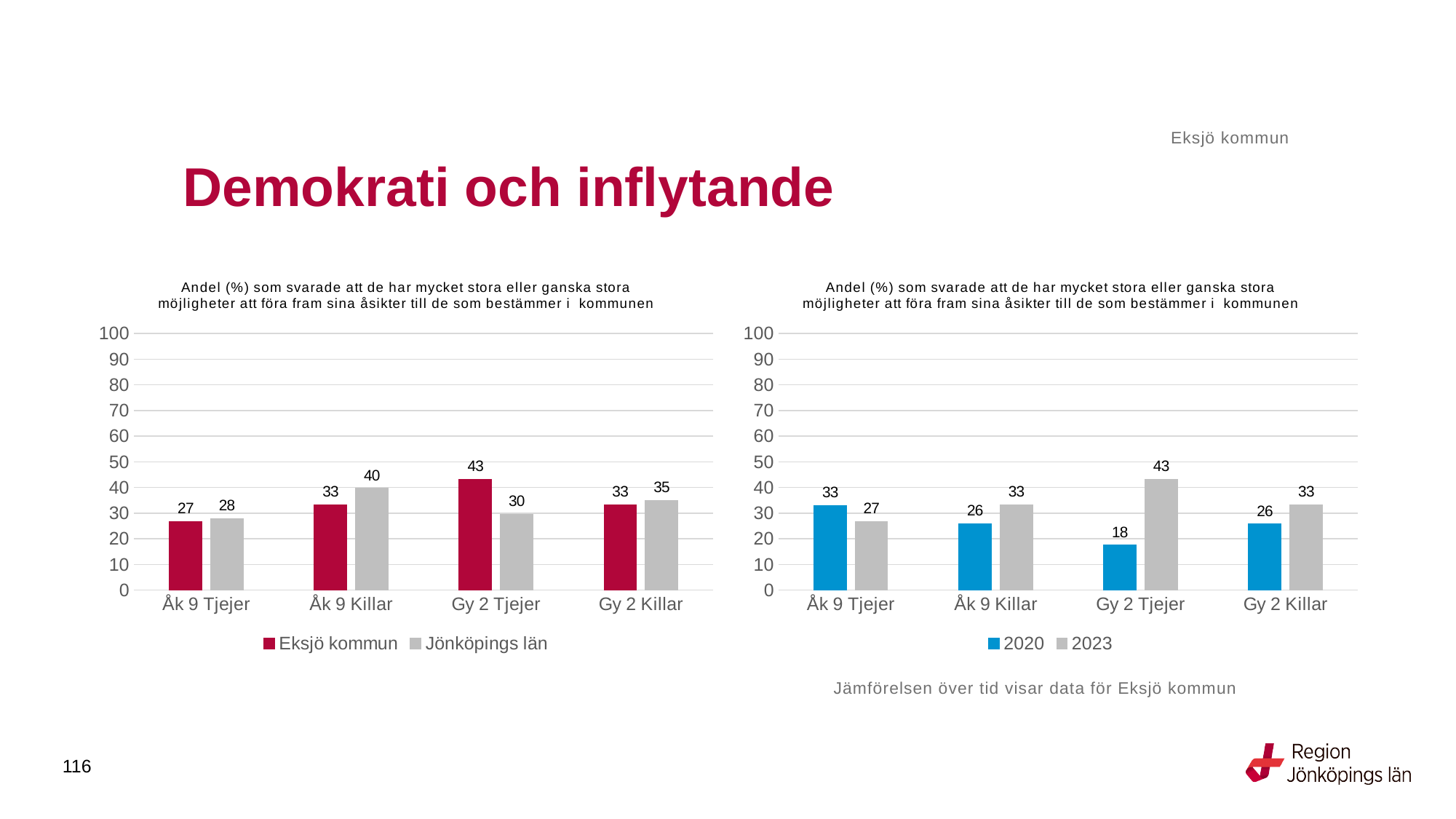
What kind of chart is the left chart? Bar chart How many series does the legend of the right chart list? 2 In the left chart, which is larger for Åk 9 Killar: Eksjö kommun or Jönköpings län? Jönköpings län In the right chart, what is the value for 2023 for Åk 9 Tjejer? 27 In the left chart, what is the value for Jönköpings län for Åk 9 Killar? 40 In the left chart, what is the difference between Eksjö kommun and Jönköpings län for Gy 2 Tjejer? 13 In the right chart, what is the value for 2020 for Gy 2 Tjejer? 18 In the right chart, what is the difference between 2023 and 2020 for Gy 2 Tjejer? 25 In the right chart, which category has the lowest value for 2020? Gy 2 Tjejer In the left chart, what is the value for Eksjö kommun for Gy 2 Tjejer? 43 In the left chart, which category has the lowest value for Jönköpings län? Åk 9 Tjejer In the left chart, which category has the highest value for Eksjö kommun? Gy 2 Tjejer